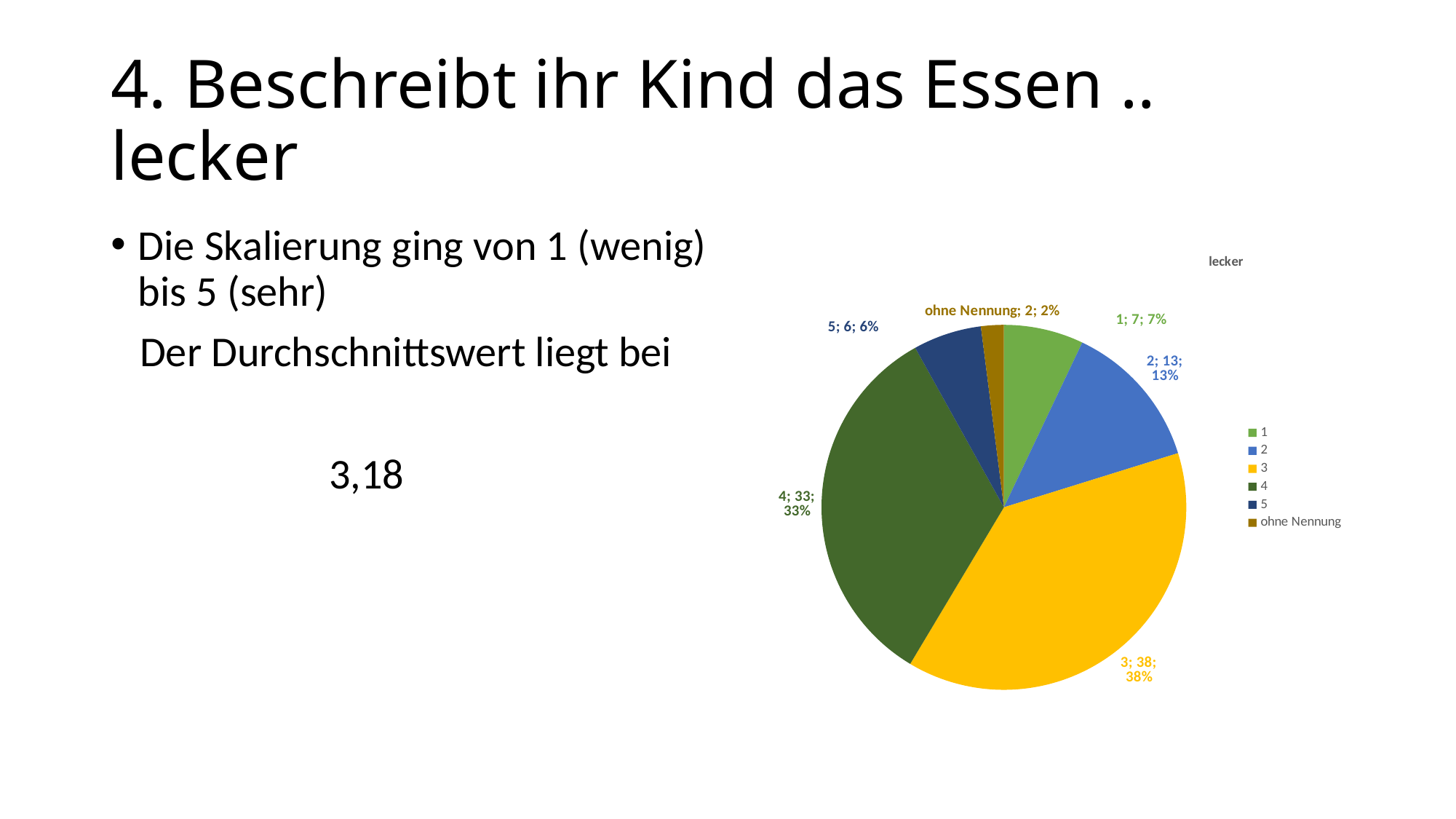
What percentage share does category 2 have in the pie chart? 13% Which category has the smallest slice in the pie chart? ohne Nennung What is the value for 'ohne Nennung' in the pie chart? 2 What percentage share does category 5 have in the pie chart? 6% What is the title of the chart? lecker How many entries does the chart legend list? 6 Which category has the largest slice in the pie chart? 3 What kind of chart is shown on the slide? pie chart What is the difference between the values for category 3 and category 4? 5 What is the value for category 3 in the pie chart? 38 What is the value for category 4 in the pie chart? 33 How many slices does the pie chart have? 6